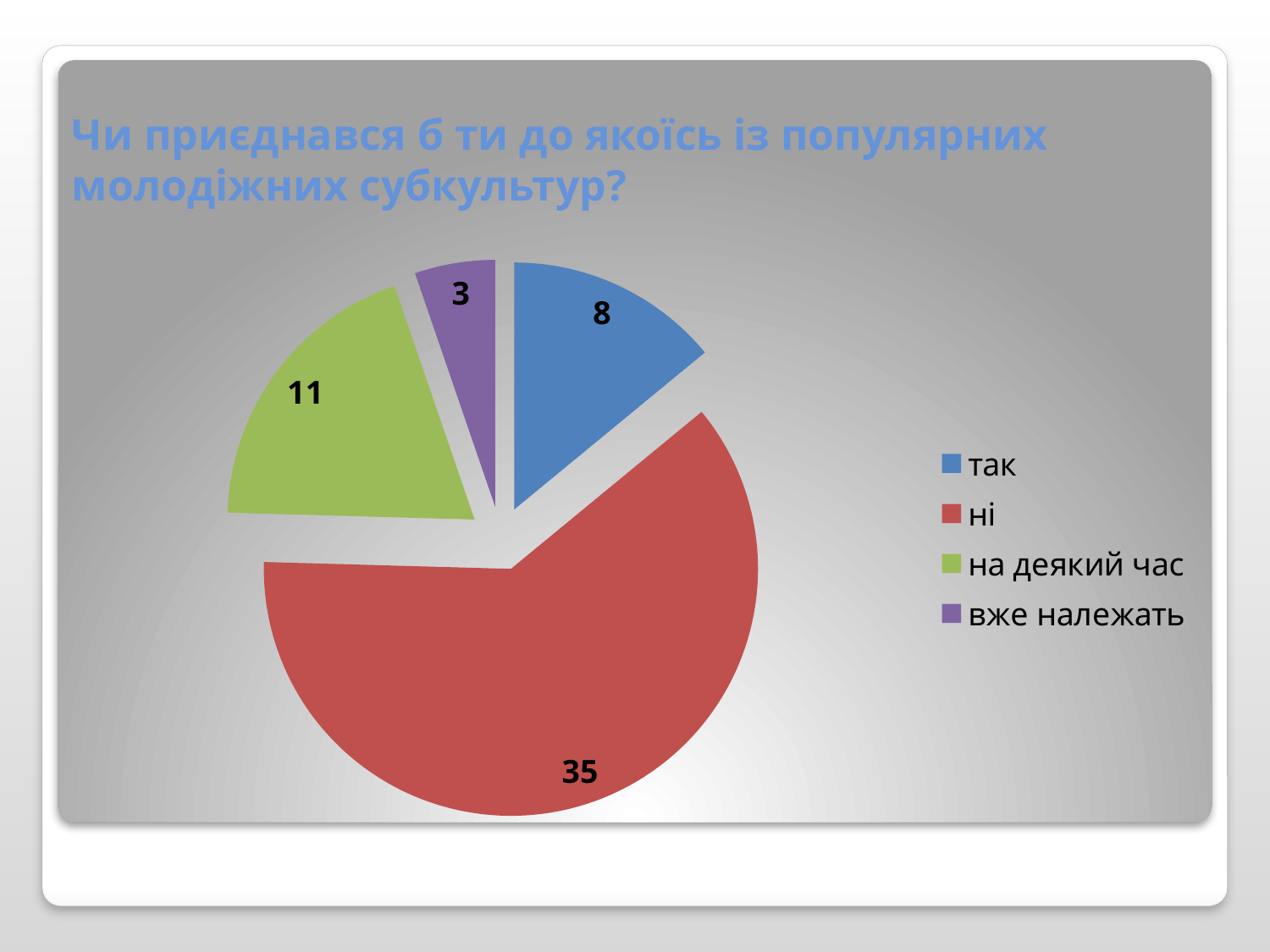
What is the value for the "вже належать" slice? 3 What is the value for the "на деякий час" slice? 11 What is the difference between the values for "на деякий час" and "вже належать"? 8 What is the value for the "ні" slice? 35 What is the value for the "так" slice? 8 What type of chart is shown on the slide? pie chart Which is larger, the value for "так" or the value for "на деякий час"? на деякий час What is the total of all the slice values in the pie chart? 57 Which category has the smallest slice? вже належать Which category has the largest slice? ні What is the difference between the values for "ні" and "так"? 27 How many categories does the pie chart have? 4